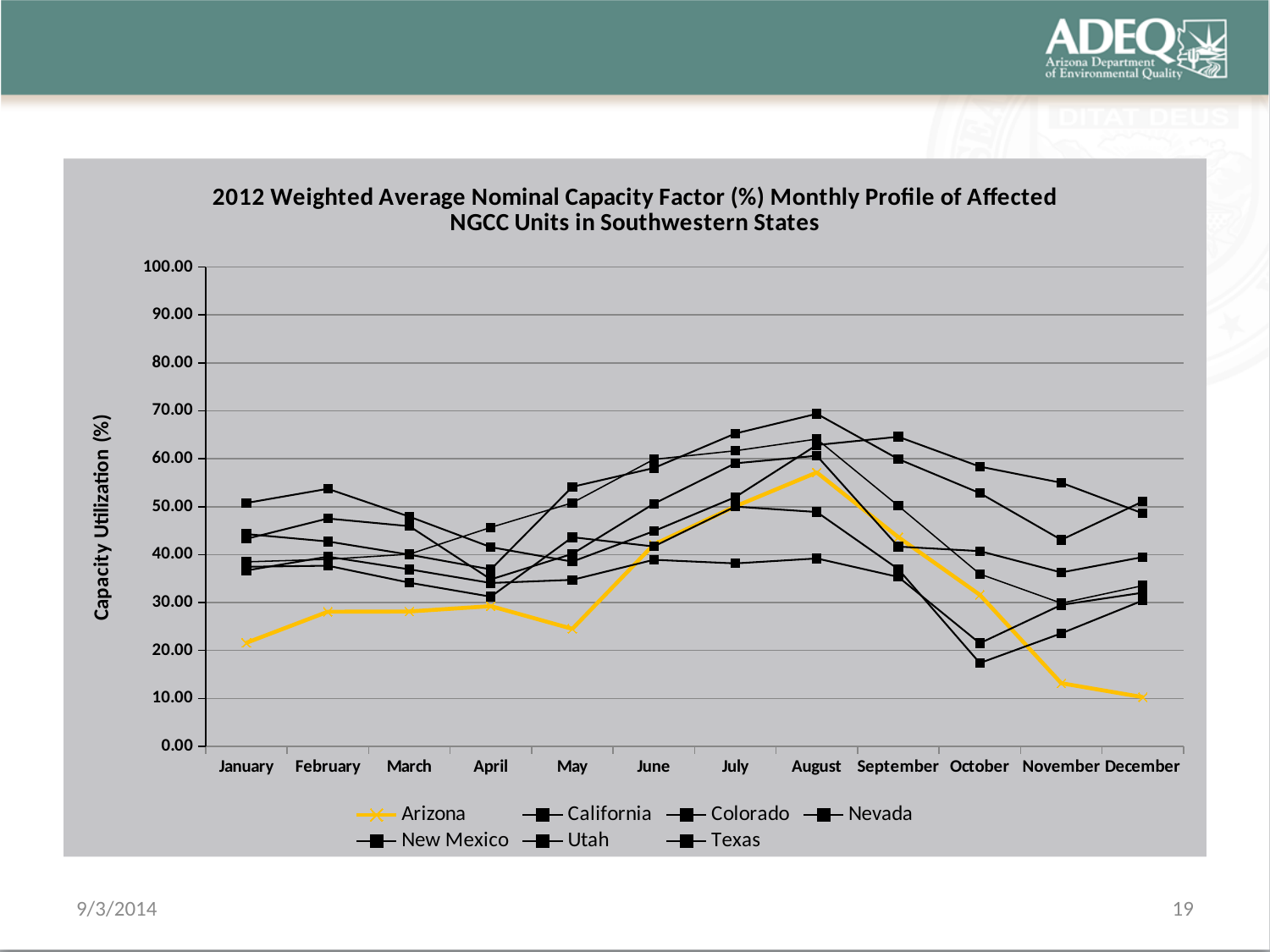
Does the Arizona series rise or fall from August to December? Fall What is the label on the y axis? Capacity Utilization (%) Is the value for Arizona in August greater or less than 50.00? greater What kind of chart is shown on the slide? Line chart In which month does the Arizona series reach its highest value? August Is the value for Arizona in January greater or less than 30.00? less What is the title of the chart? 2012 Weighted Average Nominal Capacity Factor (%) Monthly Profile of Affected NGCC Units in Southwestern States In which month does the Arizona series reach its lowest value? December Which is larger for Arizona, the value in August or the value in January? August How many series does the legend list? 7 How many months are shown along the x axis? 12 Is the value for Arizona in December greater or less than 20.00? less